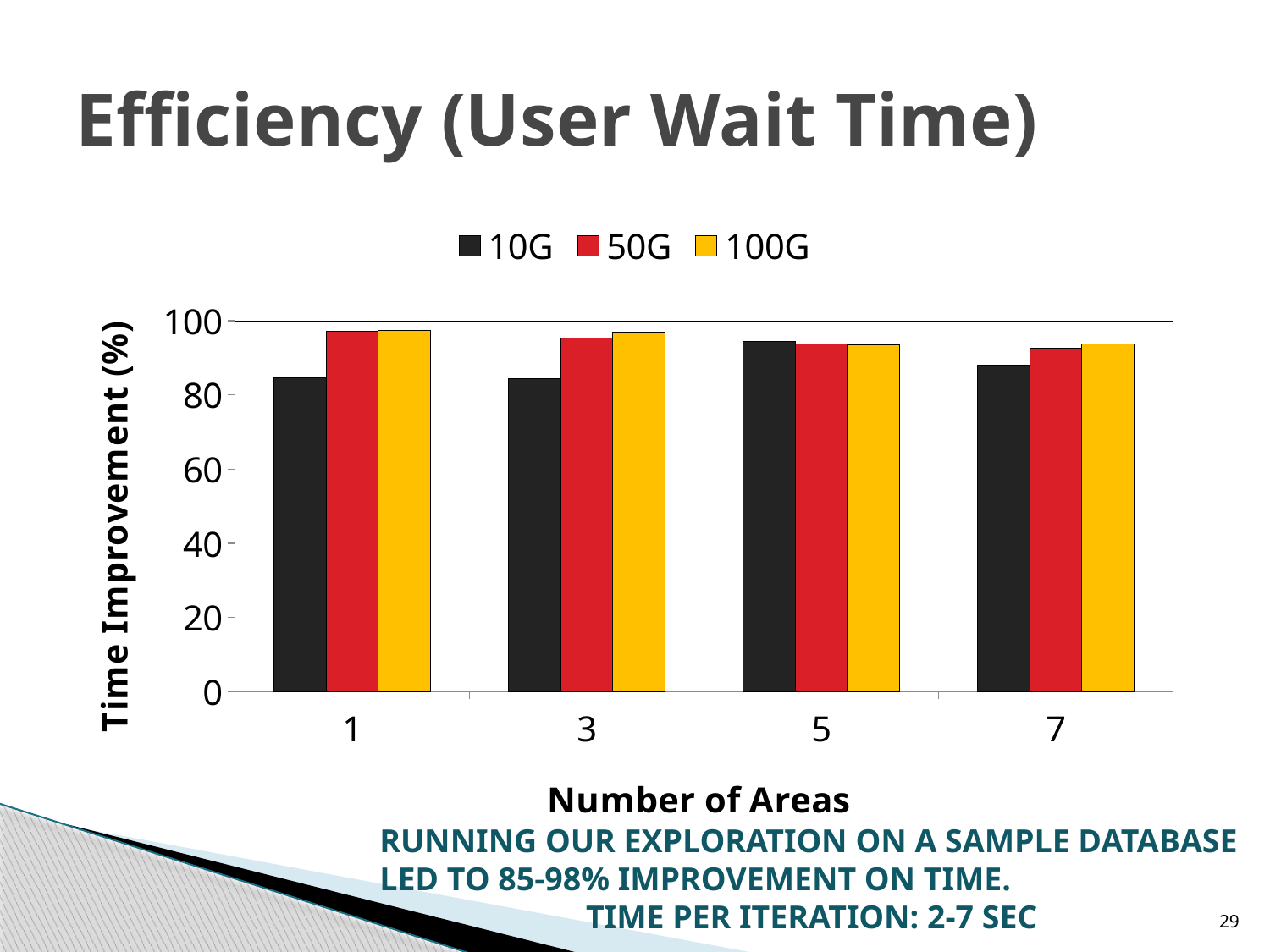
Is the value for 10G at 7 areas greater or less than 80? greater What is the label of the y axis? Time Improvement (%) Is the value for 50G at 1 area greater or less than 90? greater At 1 area, which is larger: the value for 10G or the value for 50G? 50G What is the title of the slide containing the chart? Efficiency (User Wait Time) How many series does the legend list? 3 Is the value for 100G at 3 areas greater or less than 90? greater What kind of chart is shown on the slide? bar chart At 3 areas, which is larger: the value for 10G or the value for 100G? 100G For the 10G series, at which number of areas is the value highest? 5 How many categories are shown on the x axis? 4